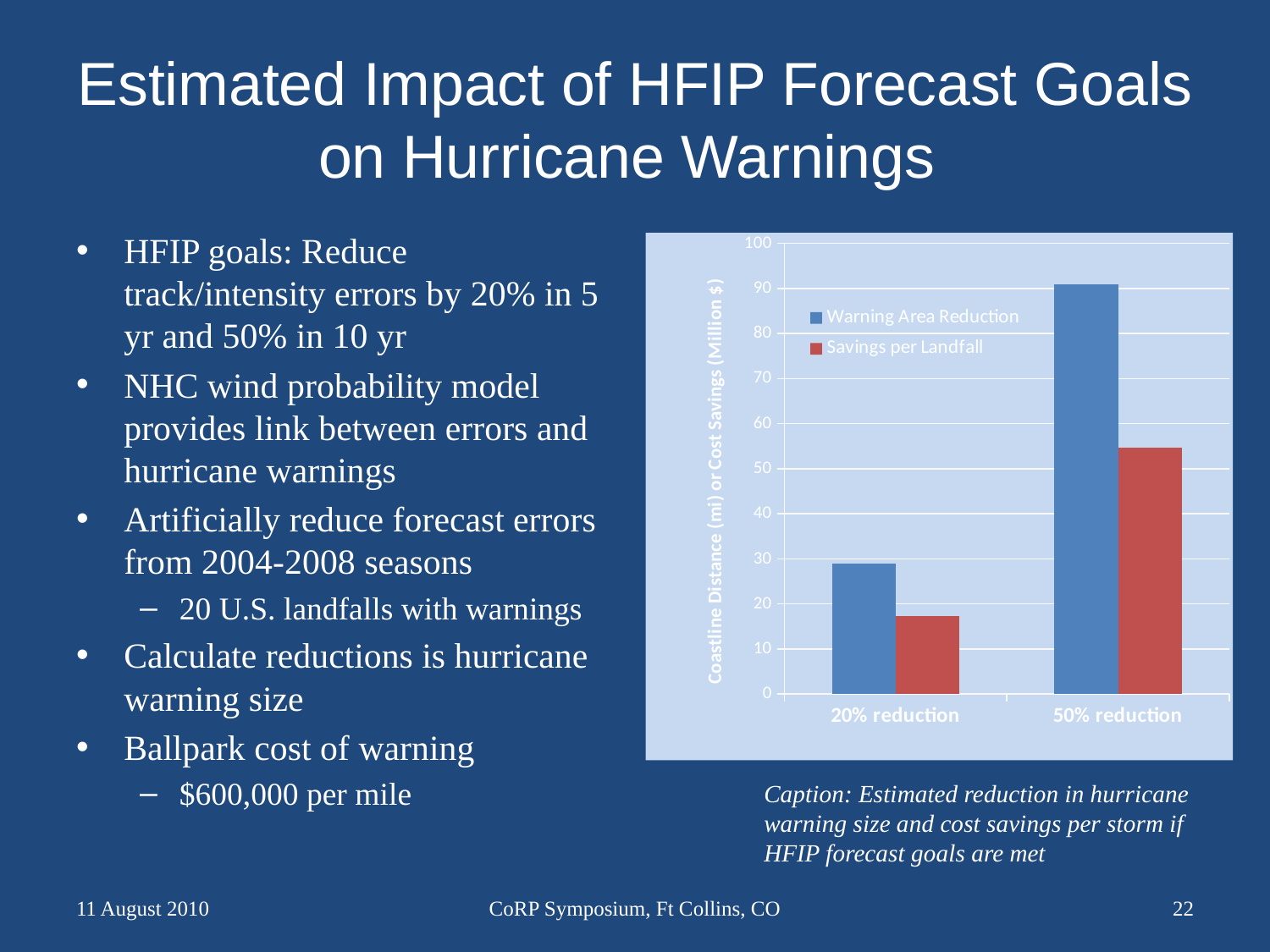
Which series and category has the tallest bar in the chart? Warning Area Reduction at 50% reduction How many categories are shown on the x axis of the chart? 2 For the 50% reduction category, which is larger: Warning Area Reduction or Savings per Landfall? Warning Area Reduction Is the Warning Area Reduction value for 20% reduction greater or less than 20? greater Which series and category has the shortest bar in the chart? Savings per Landfall at 20% reduction What is the label on the vertical axis of the chart? Coastline Distance (mi) or Cost Savings (Million $) Is the Warning Area Reduction value for 50% reduction greater or less than 80? greater Is the Savings per Landfall value for 50% reduction greater or less than 50? greater What kind of chart is shown on the slide? bar chart Do the values for both series rise or fall from 20% reduction to 50% reduction? rise How many series does the chart legend list? 2